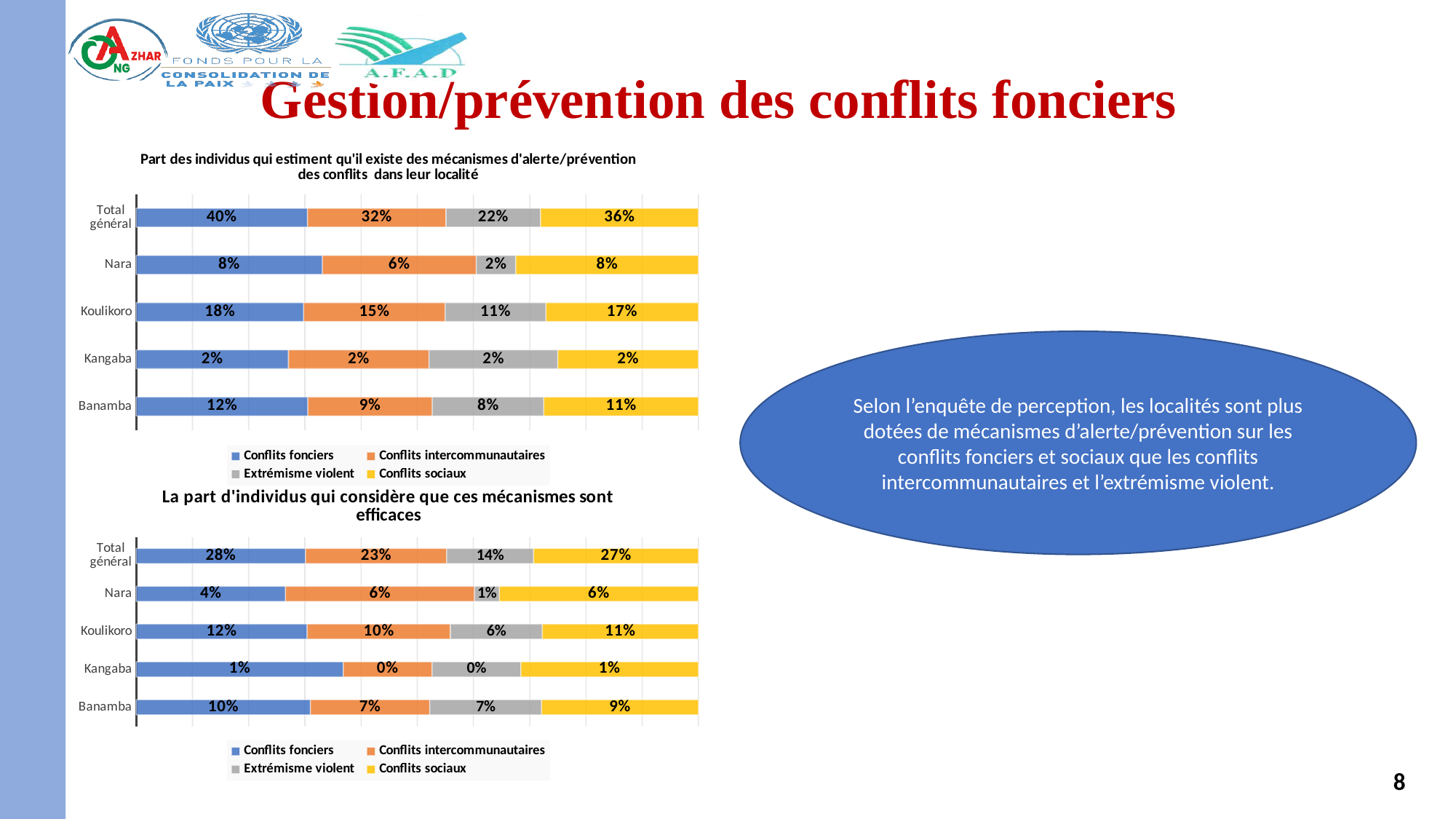
How many localities (including Total général) are shown in the bottom chart? 5 How many series does the legend of the top chart list? 4 In the top chart, which is larger for Banamba: Conflits intercommunautaires or Conflits sociaux? Conflits sociaux What type of chart is the bottom chart? Stacked bar chart In the bottom chart, which locality (excluding Total général) has the lowest value for Conflits sociaux? Kangaba In the top chart, which locality (excluding Total général) has the highest value for Conflits fonciers? Koulikoro In the top chart, what is the value for Extrémisme violent for Nara? 2% In the top chart (Part des individus qui estiment qu'il existe des mécanismes d'alerte/prévention), what is the value for Conflits fonciers for Koulikoro? 18% In the bottom chart, what is the value for Conflits intercommunautaires for Kangaba? 0% In the bottom chart (La part d'individus qui considère que ces mécanismes sont efficaces), what is the value for Conflits sociaux for Total général? 27% In the bottom chart, what is the difference between the Conflits fonciers value and the Conflits intercommunautaires value for Banamba? 3% In the top chart, what is the difference between the Conflits fonciers value and the Extrémisme violent value for Total général? 18%